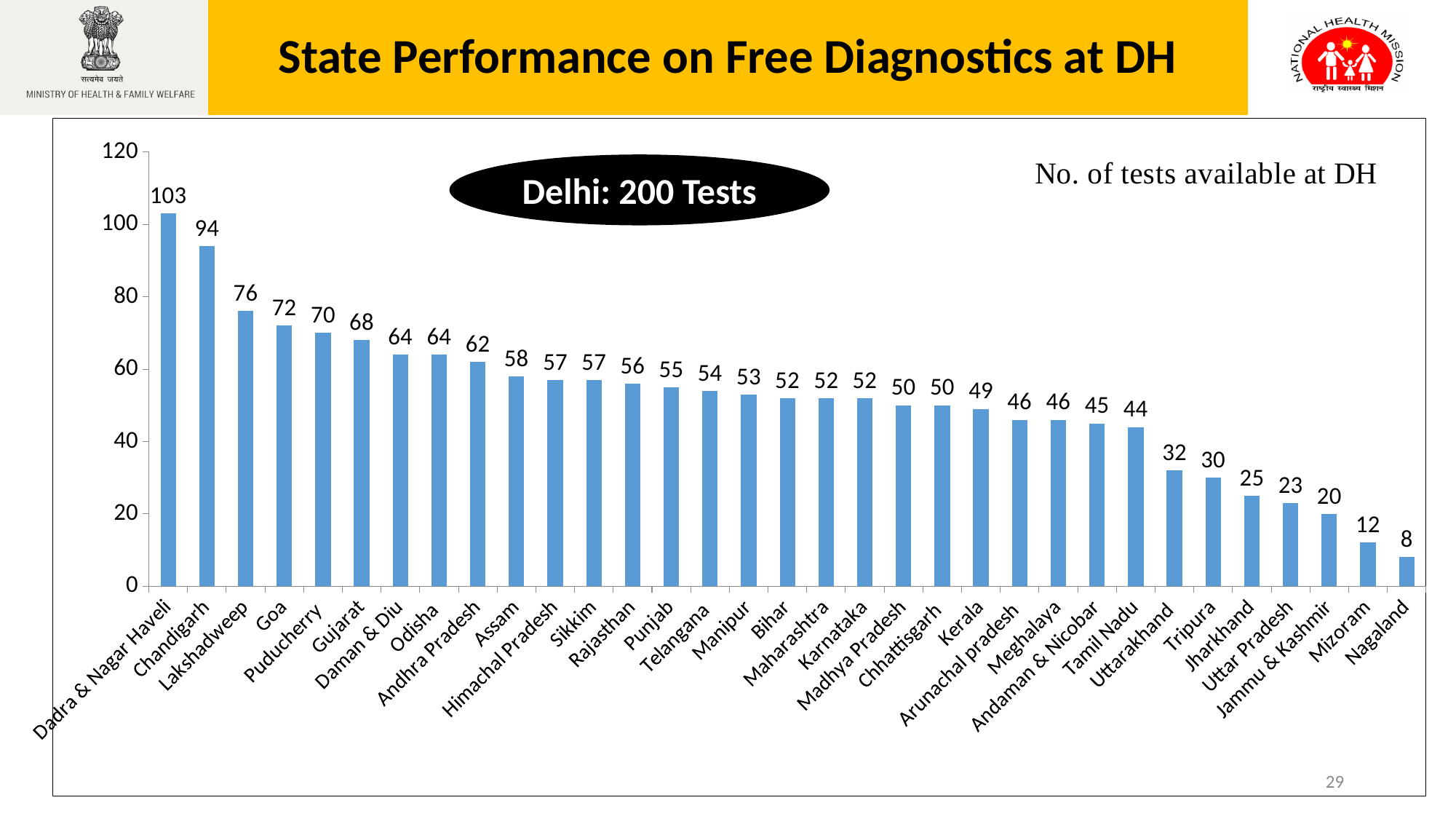
How many states and UTs are plotted as bars in the chart? 33 What is the number of tests available at DH for Uttar Pradesh? 23 What is the number of tests available at DH for Chandigarh? 94 Which has more tests available at DH, Mizoram or Tripura? Tripura What kind of chart is shown on the slide? Bar chart According to the callout on the chart, how many tests are available at DH in Delhi? 200 Tests Which has more tests available at DH, Lakshadweep or Gujarat? Lakshadweep What is the number of tests available at DH for Kerala? 49 Which state has the lowest number of tests available at DH? Nagaland What is the difference between the number of tests for Goa and Tamil Nadu? 28 Which state or UT has the highest number of tests available at DH among the plotted bars? Dadra & Nagar Haveli What is the difference between the number of tests for Dadra & Nagar Haveli and Chandigarh? 9